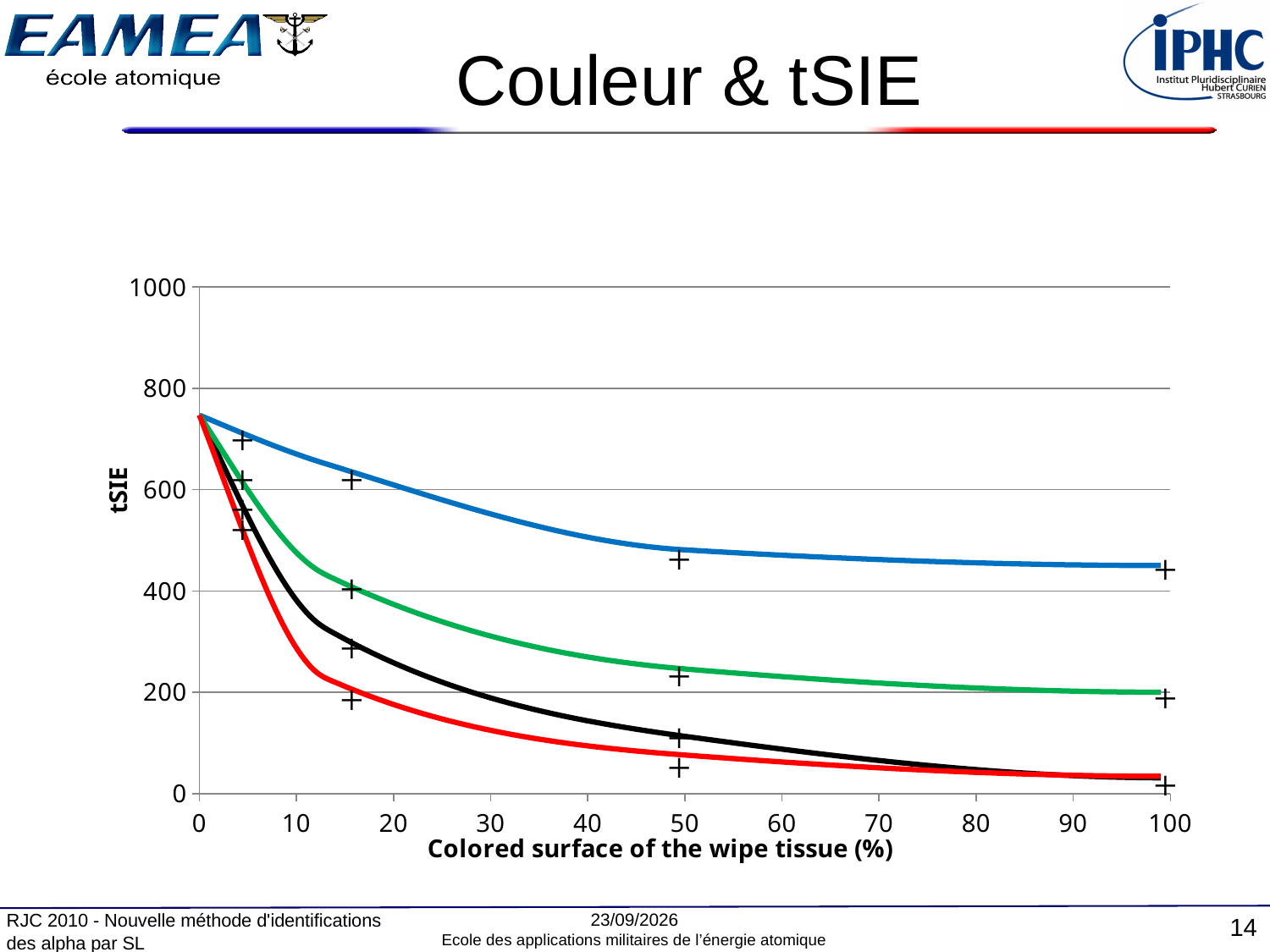
Is the tSIE value of the red curve at 100% colored surface greater or less than 200? less Is the tSIE value of the blue curve at 100% colored surface greater or less than 400? greater Is the tSIE value of the blue curve at 0% colored surface greater or less than 600? greater What is the title of the y axis? tSIE At 50% colored surface, which curve has the larger tSIE value, the blue one or the green one? the blue curve Which curve has the highest tSIE value at 100% colored surface? the blue curve Which curve has the lowest tSIE value at 20% colored surface? the red curve How many curves are plotted on the chart? 4 What is the title of the x axis? Colored surface of the wipe tissue (%) Do the tSIE values rise or fall as the colored surface percentage increases? fall What kind of chart is shown on the slide? line chart